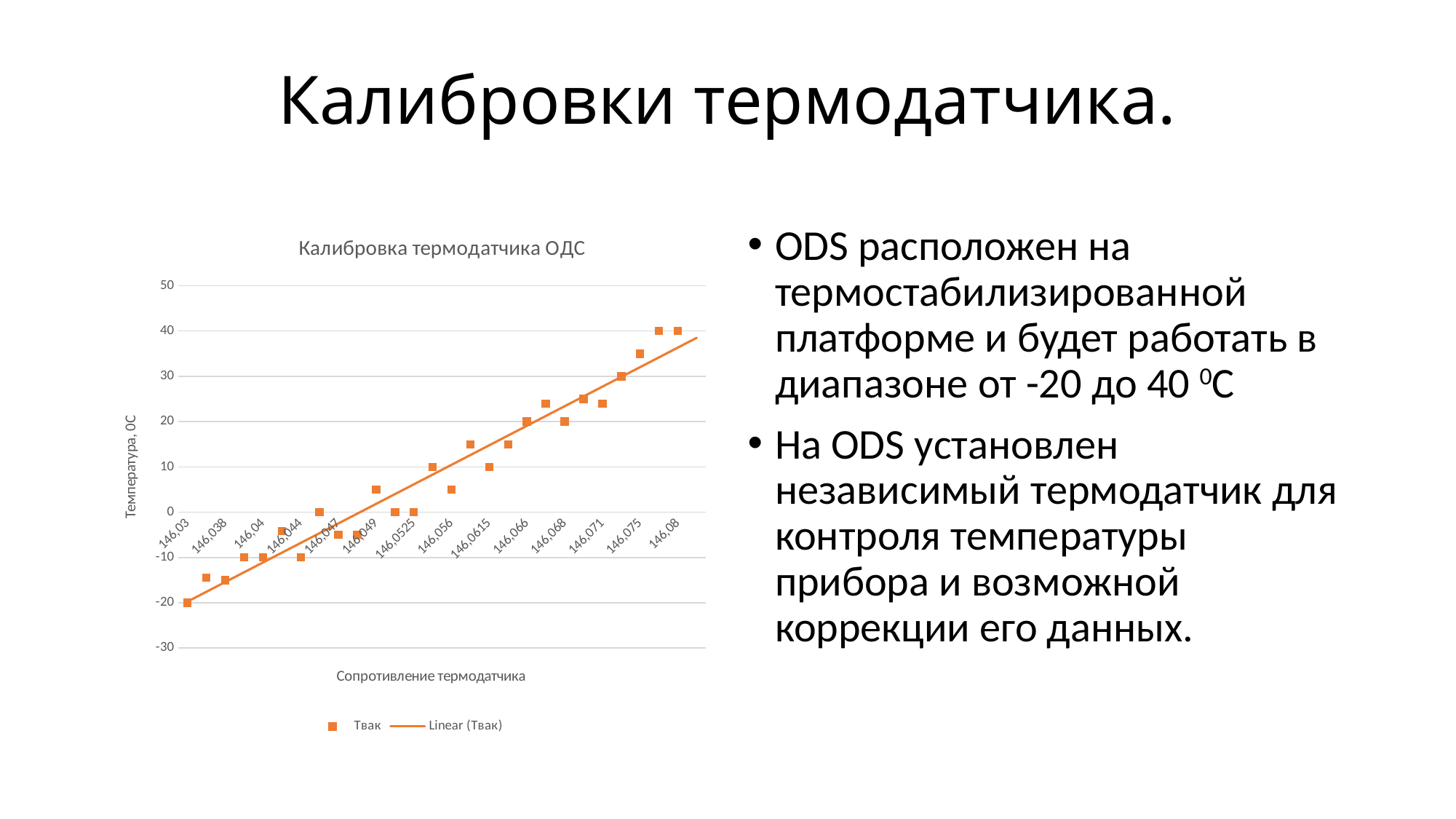
What is the difference between the highest and lowest plotted temperature values? 60 What is the title of the chart? Калибровка термодатчика ОДС How many resistance labels are shown on the x axis? 14 Do the plotted temperature values rise or fall as the resistance increases along the x axis? rise What kind of chart is shown on the slide? scatter chart Is the temperature value at resistance 146,03 greater or less than 0? less How many entries does the chart legend list? 2 What are the two entries in the chart legend? Твак and Linear (Твак) What is the highest temperature value plotted on the chart? 40 Is the temperature value at resistance 146,08 greater or less than 30? greater What is the lowest temperature value plotted on the chart? -20 Which has the larger temperature value: the point at 146,03 or the point at 146,08? 146,08